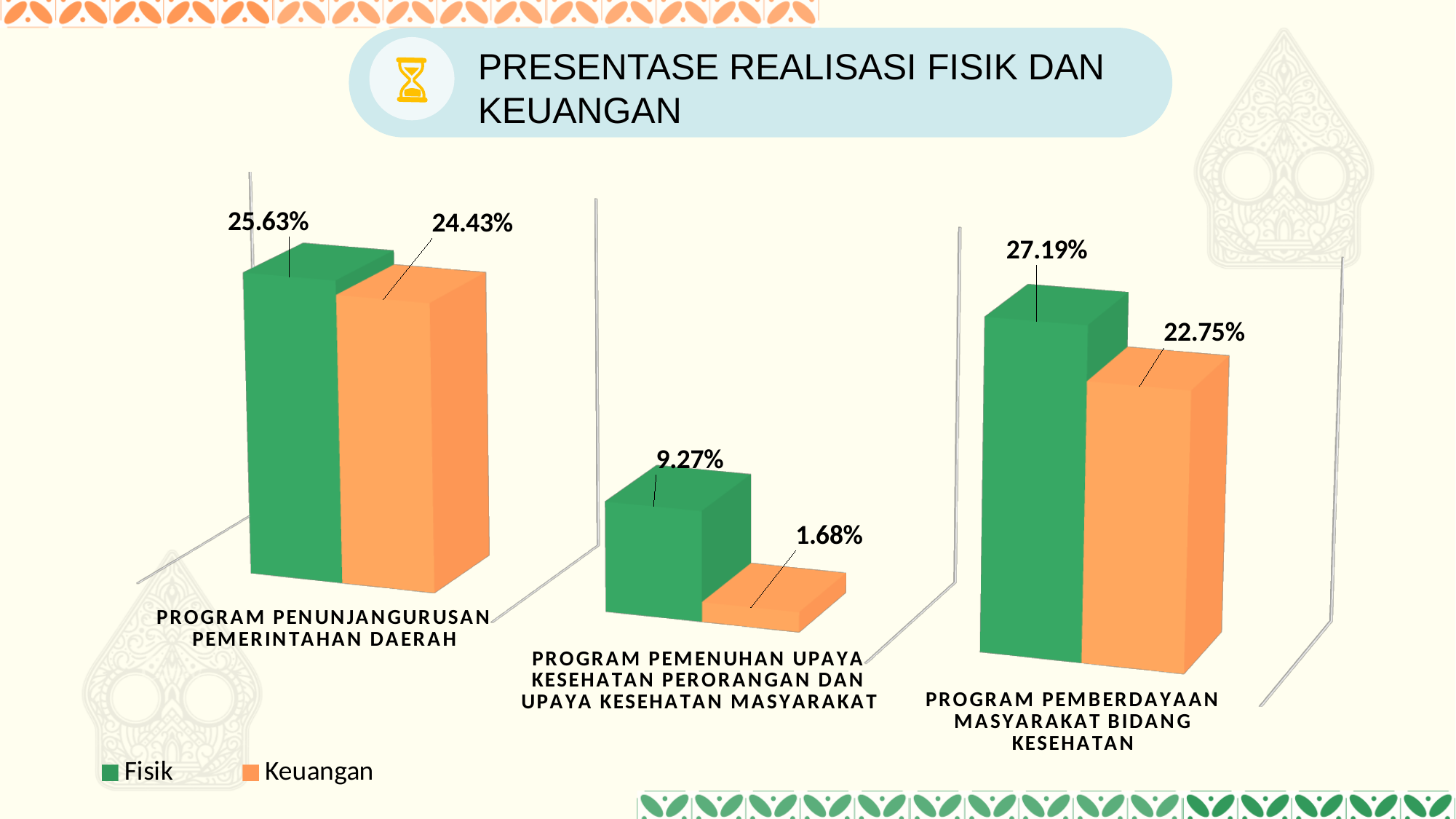
What is the Keuangan value for Program Pemberdayaan Masyarakat Bidang Kesehatan? 22.75% What is the title of the chart? PRESENTASE REALISASI FISIK DAN KEUANGAN What kind of chart is shown on the slide? Bar chart How many series does the legend list? 2 What is the Keuangan value for Program Pemenuhan Upaya Kesehatan Perorangan dan Upaya Kesehatan Masyarakat? 1.68% What is the difference between the Fisik and Keuangan values for Program Pemenuhan Upaya Kesehatan Perorangan dan Upaya Kesehatan Masyarakat? 7.59% Which is larger for Program Penunjangurusan Pemerintahan Daerah, the Fisik value or the Keuangan value? Fisik What is the Fisik value for Program Penunjangurusan Pemerintahan Daerah? 25.63% What is the difference between the Fisik and Keuangan values for Program Pemberdayaan Masyarakat Bidang Kesehatan? 4.44% Which program has the lowest Keuangan value? Program Pemenuhan Upaya Kesehatan Perorangan dan Upaya Kesehatan Masyarakat Which program has the highest Fisik value? Program Pemberdayaan Masyarakat Bidang Kesehatan How many programs are shown on the chart? 3